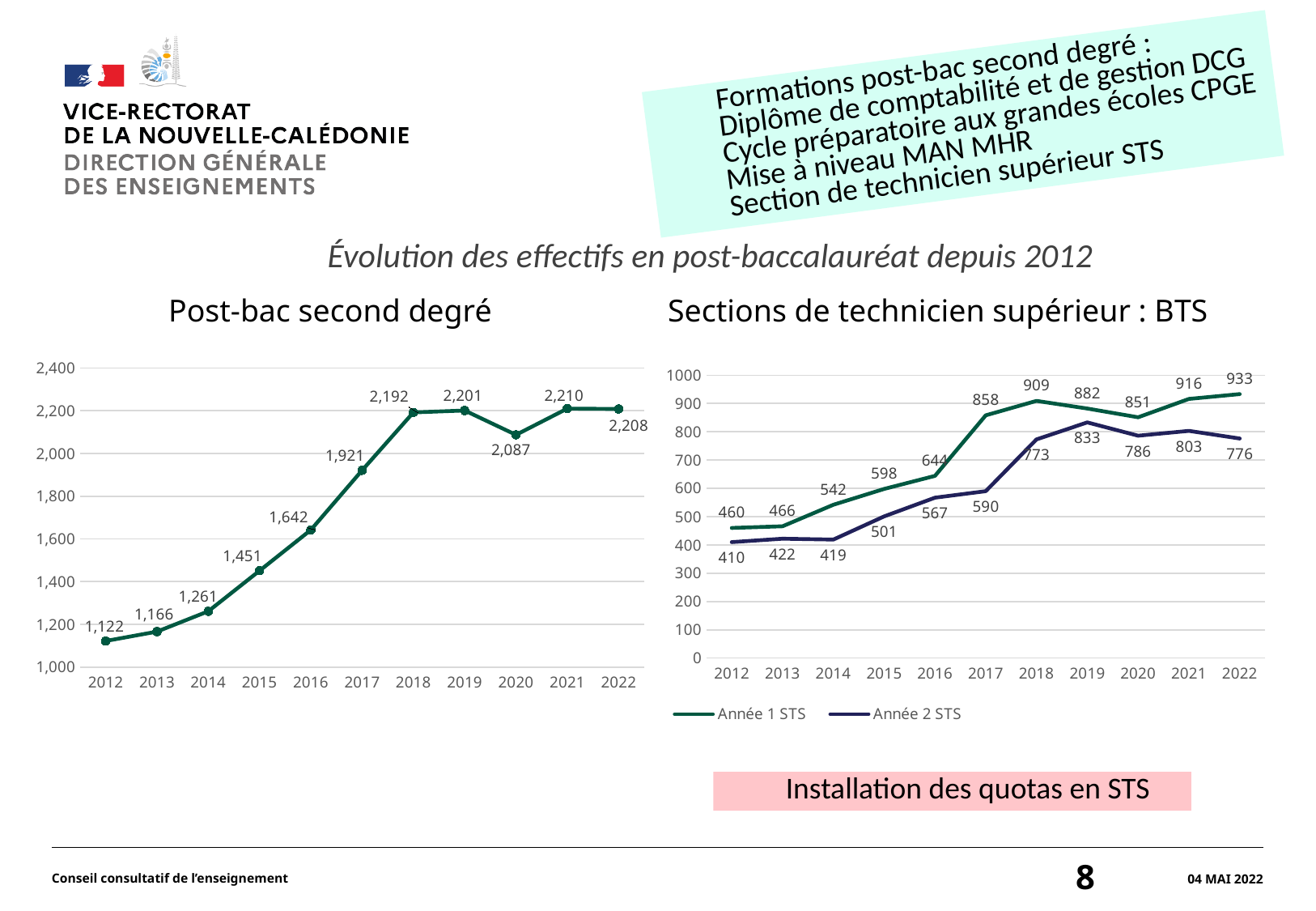
In the 'Sections de technicien supérieur : BTS' chart, what is the difference between Année 1 STS and Année 2 STS in 2018? 136 In the 'Sections de technicien supérieur : BTS' chart, what is the value for Année 1 STS in 2022? 933 In the 'Post-bac second degré' chart, which year has the highest value? 2021 In the 'Sections de technicien supérieur : BTS' chart, which year has the lowest value for Année 2 STS? 2012 How many series does the legend of the 'Sections de technicien supérieur : BTS' chart list? 2 In the 'Post-bac second degré' chart, do the values rise or fall from 2012 to 2018? Rise In the 'Sections de technicien supérieur : BTS' chart, what is the value for Année 2 STS in 2019? 833 In the 'Post-bac second degré' chart, what is the value for 2012? 1,122 In the 'Sections de technicien supérieur : BTS' chart, which is larger in 2020: Année 1 STS or Année 2 STS? Année 1 STS What kind of chart is the 'Post-bac second degré' chart? Line chart In the 'Post-bac second degré' chart, how many years are plotted on the x axis? 11 In the 'Post-bac second degré' chart, what is the difference between the 2018 value and the 2017 value? 271